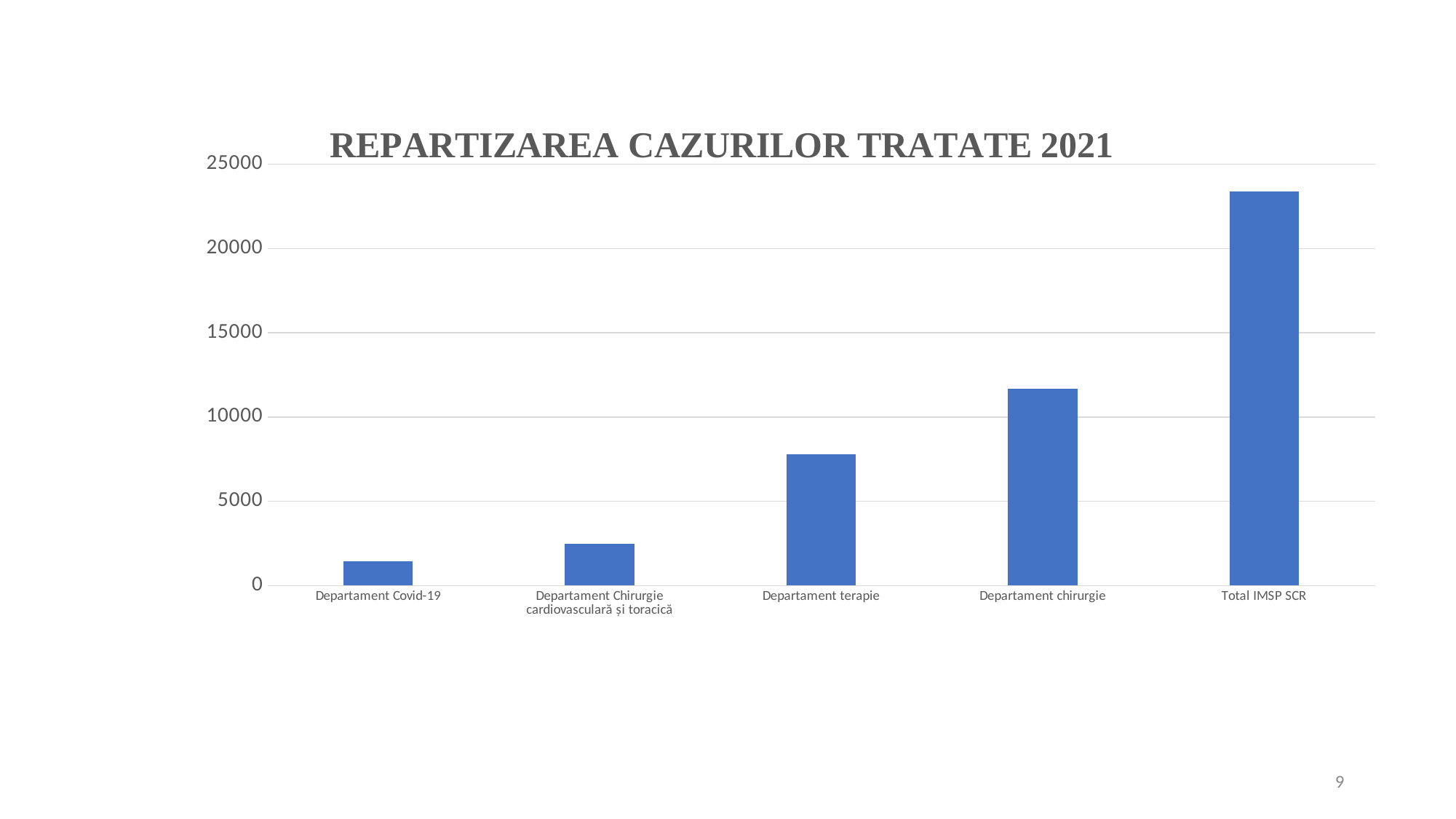
Which category has the lowest value? Departament Covid-19 How many categories are shown on the x axis? 5 Which is larger, the value for Departament Covid-19 or the value for Departament Chirurgie cardiovasculară și toracică? Departament Chirurgie cardiovasculară și toracică What type of chart is shown on the slide? bar chart Is the value for Departament chirurgie greater or less than 10000? greater Do the values rise or fall from left to right along the x axis? rise What is the title of the chart? REPARTIZAREA CAZURILOR TRATATE 2021 Which category has the highest value? Total IMSP SCR Is the value for Total IMSP SCR greater or less than 20000? greater Is the value for Departament Chirurgie cardiovasculară și toracică greater or less than 5000? less Which is larger, the value for Departament terapie or the value for Departament chirurgie? Departament chirurgie